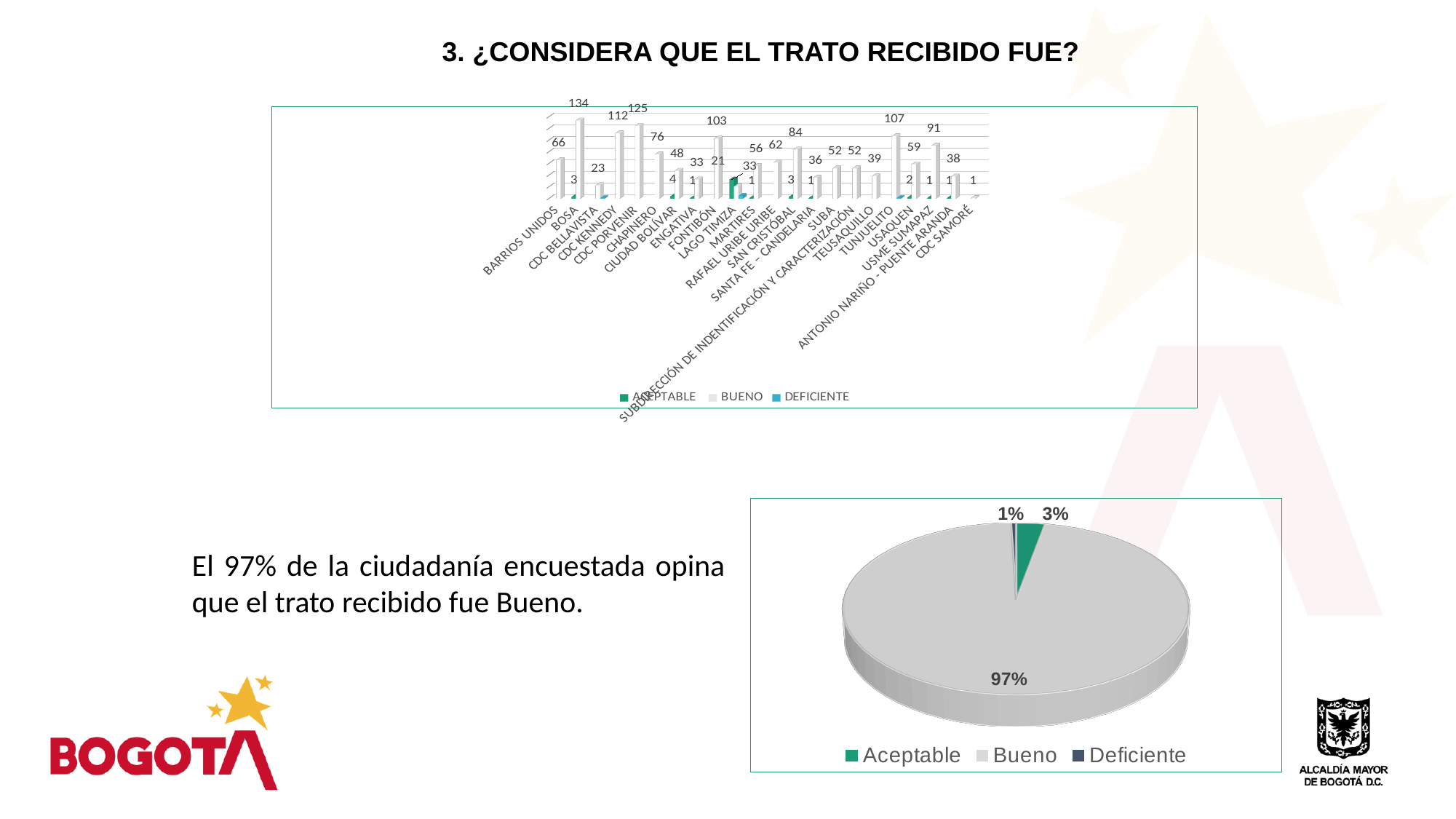
In the bar chart at the top of the slide, which locality has the highest BUENO value? BOSA How many series does the legend of the bar chart at the top of the slide list? 3 In the pie chart at the bottom right, how many percentage points larger is the Bueno slice than the Aceptable slice? 94 In the pie chart at the bottom right, what share of respondents said the treatment was Aceptable? 3% In the pie chart at the bottom right, which category has the smallest slice? Deficiente What kind of chart is shown at the bottom right of the slide? Pie chart How many categories does the legend of the pie chart at the bottom right list? 3 In the pie chart at the bottom right, which category has the largest slice? Bueno In the bar chart at the top of the slide, what is the BUENO value for BOSA? 134 In the pie chart at the bottom right, what share of respondents said the treatment was Deficiente? 1% What kind of chart is shown at the top of the slide? Bar chart In the pie chart at the bottom right, what share of respondents said the treatment was Bueno? 97%